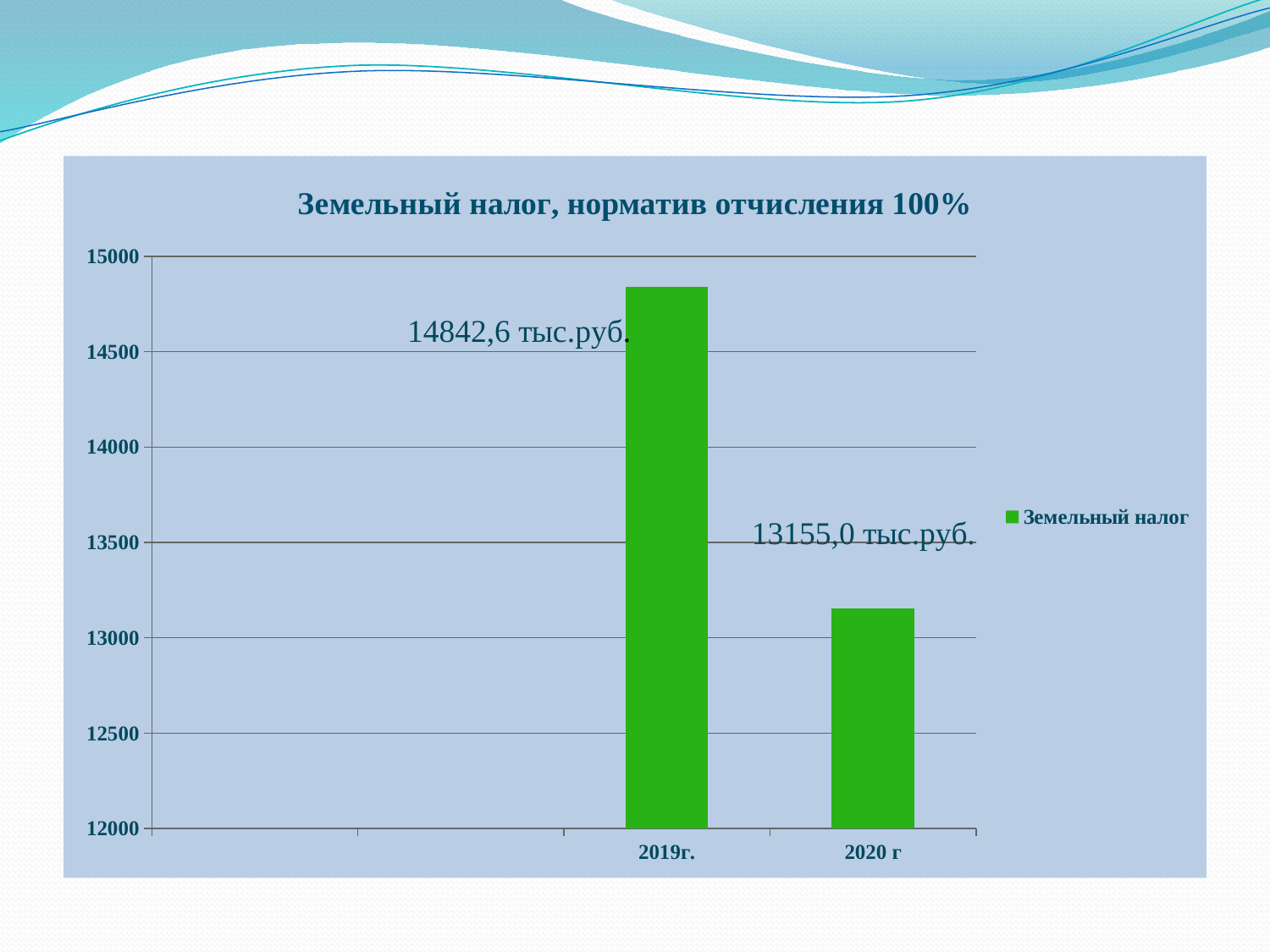
Which year has the highest value? 2019г. Is the value for 2020 г greater or less than 13500? less What is the title of the chart? Земельный налог, норматив отчисления 100% Is the value for 2019г. greater or less than 14500? greater How many series does the legend list? 1 How many categories are shown on the x axis? 2 What kind of chart is shown on the slide? bar chart Which is larger, the value for 2019г. or the value for 2020 г? 2019г. What is the value for 2020 г? 13155,0 тыс.руб. What is the difference between the values for 2019г. and 2020 г? 1687,6 тыс.руб. Which year has the lowest value? 2020 г What is the value for 2019г.? 14842,6 тыс.руб.